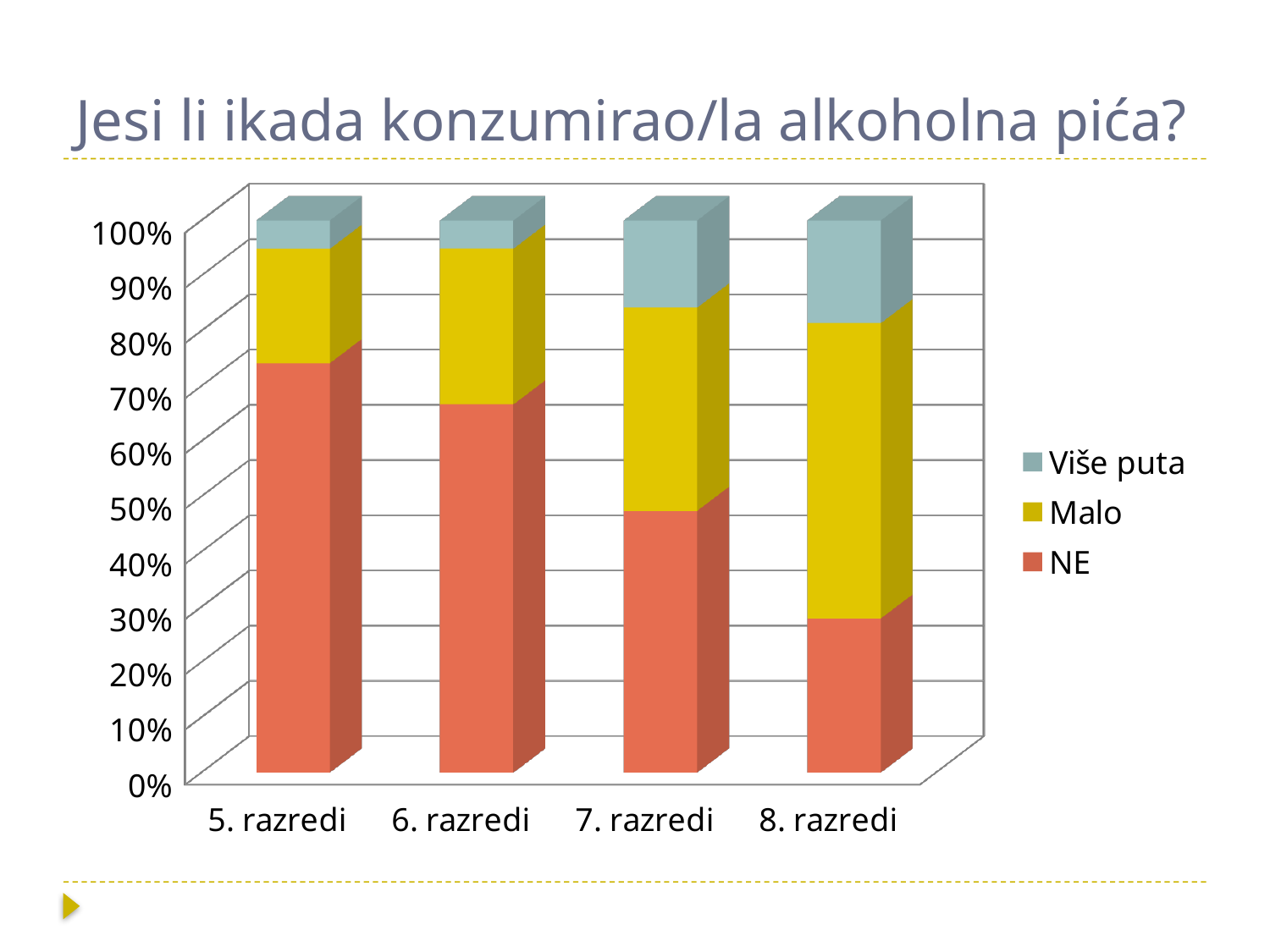
What is the title of the chart? Jesi li ikada konzumirao/la alkoholna pića? Is the NE share for 5. razredi greater or less than 70%? greater Is the NE share for 7. razredi greater or less than 60%? less How many categories (grades) are shown on the x axis? 4 Which grade has the larger Više puta share, 5. razredi or 7. razredi? 7. razredi Which grade has the lowest NE share? 8. razredi What kind of chart is shown on the slide? Stacked bar chart Does the NE share rise or fall from 5. razredi to 8. razredi? fall How many series does the legend list? 3 Which series is shown in red/orange in the legend? NE Which grade has the highest NE share? 5. razredi Is the NE share for 8. razredi greater or less than 40%? less